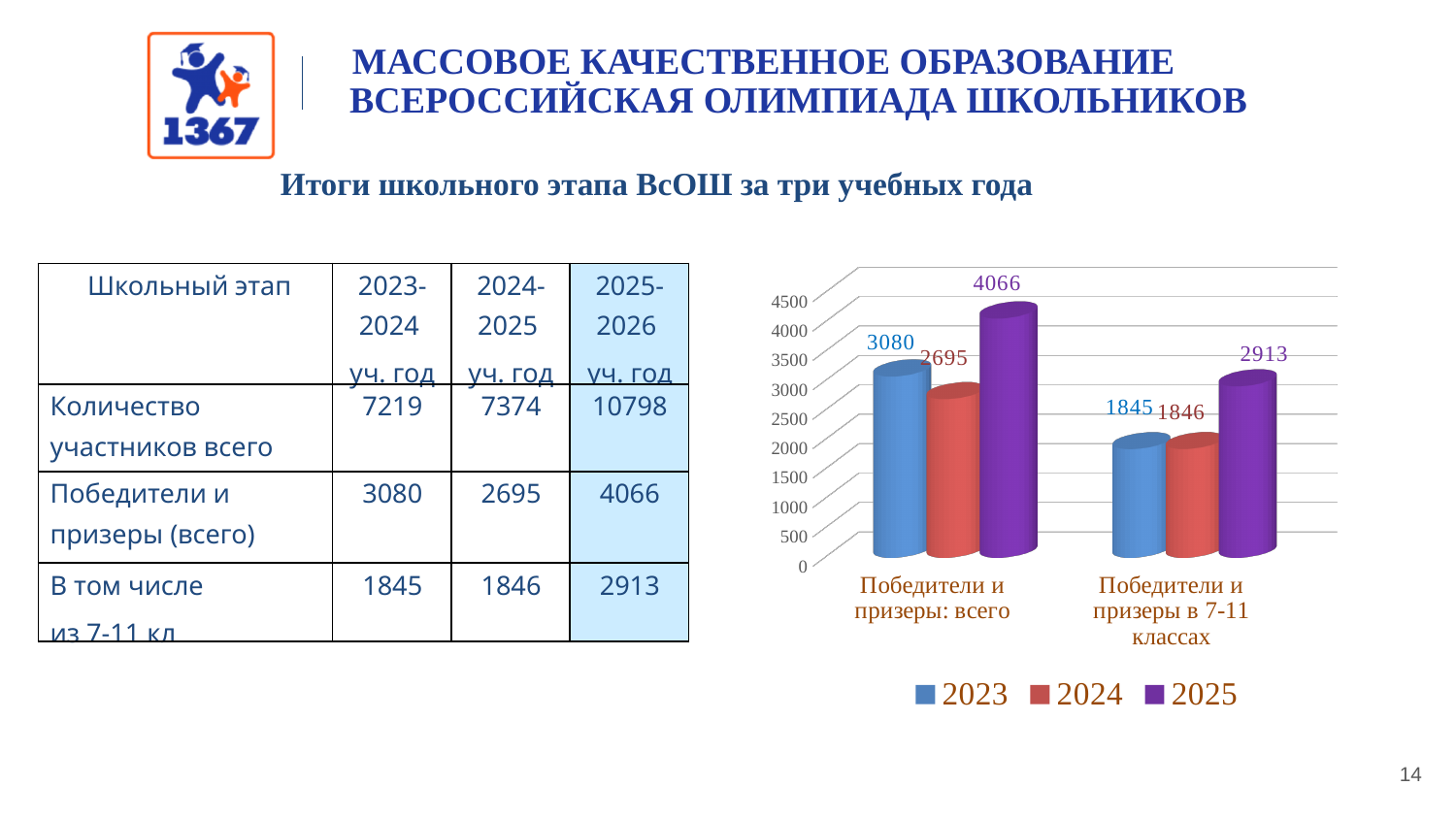
How many categories are shown on the x axis of the chart? 2 Which series has the highest value in the category "Победители и призеры: всего"? 2025 What is the value for 2025 in the category "Победители и призеры: всего"? 4066 Which series has the lowest value in the category "Победители и призеры: всего"? 2024 What kind of chart is shown on the slide? bar chart What is the difference between the 2025 and 2023 values in the category "Победители и призеры: всего"? 986 What is the value for 2023 in the category "Победители и призеры в 7-11 классах"? 1845 Which series is shown in purple in the chart? 2025 What is the value for 2024 in the category "Победители и призеры: всего"? 2695 How many series does the chart legend list? 3 What is the value for 2025 in the category "Победители и призеры в 7-11 классах"? 2913 Which is larger: the 2023 value or the 2025 value in the category "Победители и призеры в 7-11 классах"? 2025